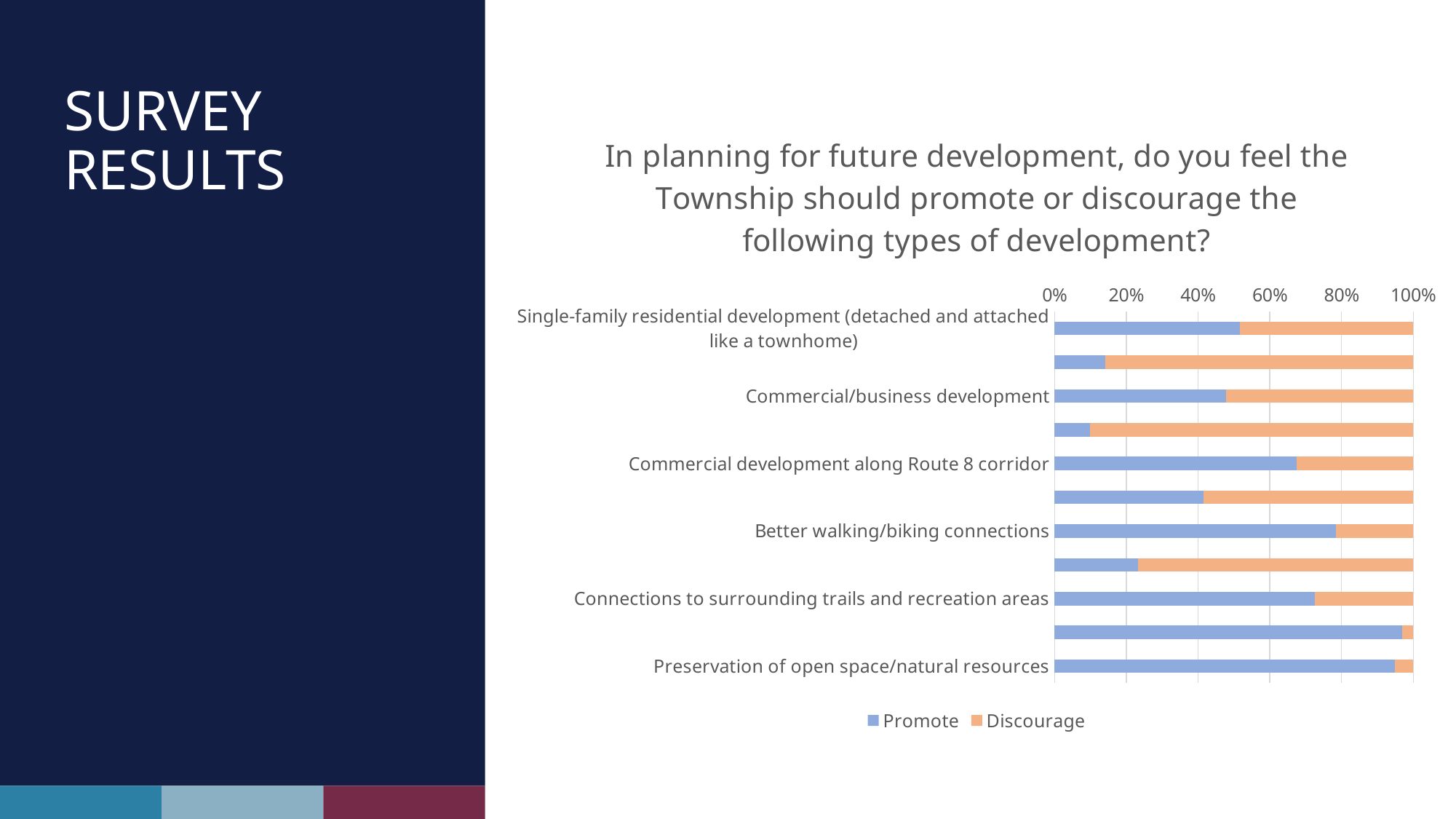
Is the Promote share for Commercial/business development greater or less than 60%? less Is the Promote share for Connections to surrounding trails and recreation areas greater or less than 80%? less What are the two series named in the legend? Promote and Discourage Is the Promote share for Commercial development along Route 8 corridor greater or less than 60%? greater What kind of chart is shown on the slide? Stacked bar chart How many series does the legend list? 2 Which has the larger Promote share: Better walking/biking connections or Commercial/business development? Better walking/biking connections Which has the larger Discourage share: Commercial/business development or Preservation of open space/natural resources? Commercial/business development Which colour represents the Discourage series? Orange Among the labelled categories, which has the highest Promote share? Preservation of open space/natural resources